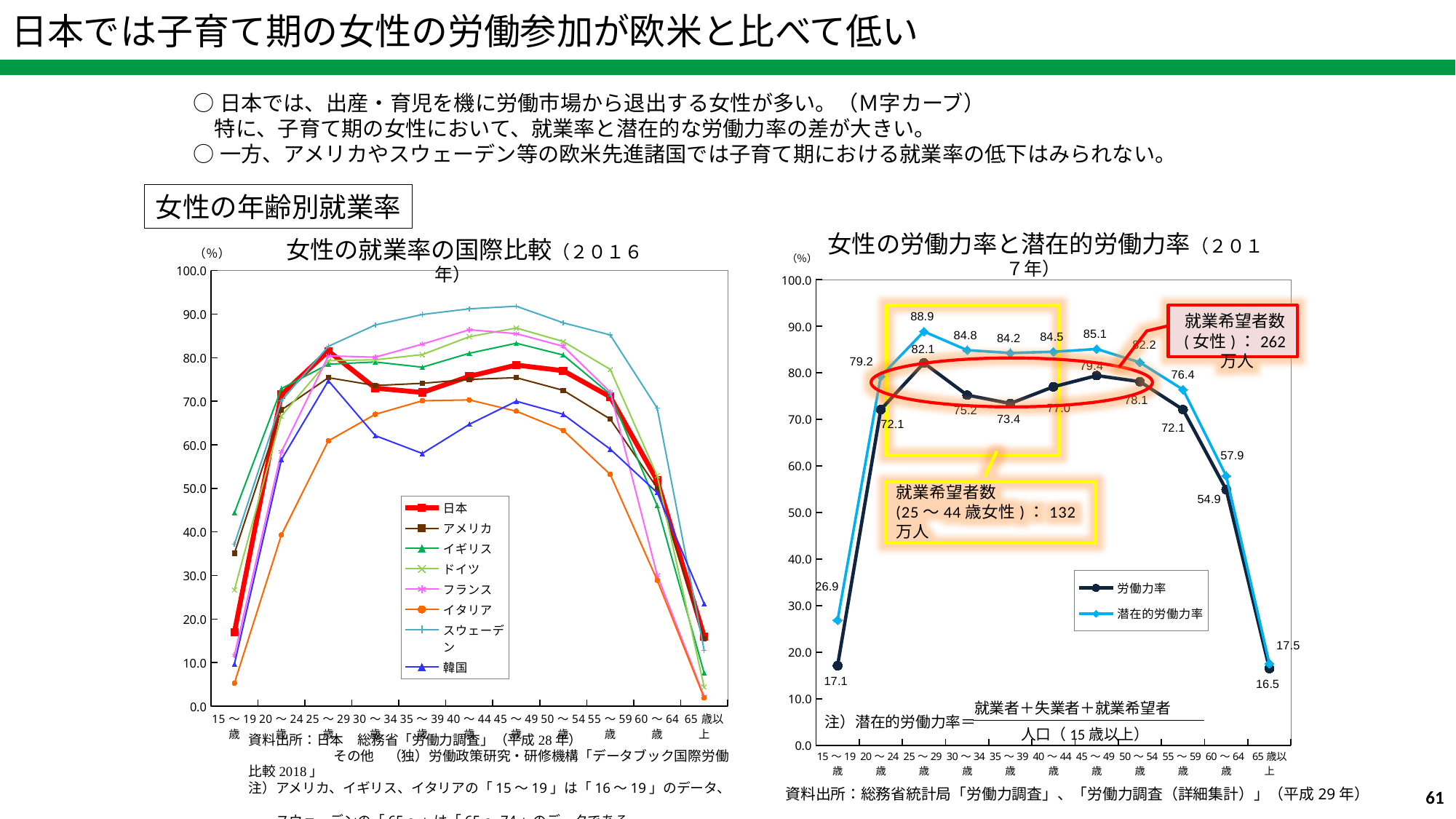
How many age categories are shown on the x axis of the left chart (女性の就業率の国際比較)? 11 In the left chart (女性の就業率の国際比較), which series is drawn with a thick red line? 日本 How many series does the legend of the right chart (女性の労働力率と潜在的労働力率) list? 2 In the right chart (女性の労働力率と潜在的労働力率), what is the 労働力率 value for 25～29歳? 82.1 In the right chart (女性の労働力率と潜在的労働力率), what is the 潜在的労働力率 value for 30～34歳? 84.8 In the right chart (女性の労働力率と潜在的労働力率), which age group has the highest 潜在的労働力率? 25～29歳 In the left chart (女性の就業率の国際比較), is the value for 日本 at 35～39歳 greater or less than 80.0? less In the right chart (女性の労働力率と潜在的労働力率), which is larger for 15～19歳: 労働力率 or 潜在的労働力率? 潜在的労働力率 In the right chart (女性の労働力率と潜在的労働力率), what is the difference between 潜在的労働力率 and 労働力率 for 35～39歳? 10.8 What kind of chart is the left chart (女性の就業率の国際比較)? Line chart In the right chart (女性の労働力率と潜在的労働力率), which age group has the lowest 労働力率? 65歳以上 How many series does the legend of the left chart (女性の就業率の国際比較) list? 8